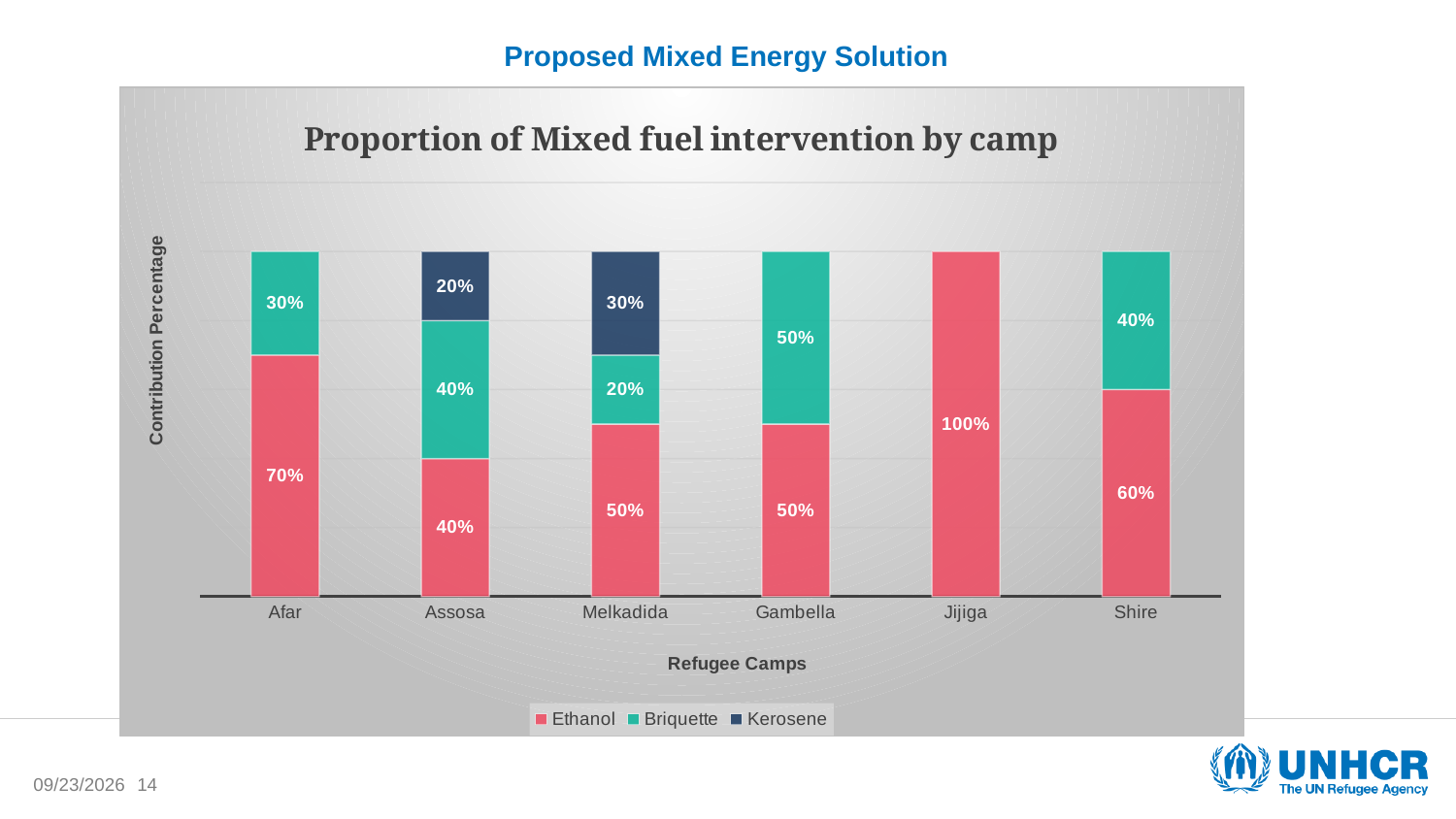
How many refugee camps are shown on the x axis? 6 What is the Kerosene value for Melkadida? 30% What is the difference between the Ethanol values for Afar and Shire? 10% How many series does the legend list? 3 What is the Briquette value for Gambella? 50% What is the Ethanol value for Afar? 70% What kind of chart is shown? Stacked bar chart Which camp has the highest Ethanol value? Jijiga Which is larger, the Briquette value for Assosa or the Briquette value for Shire? Neither; they are equal (both 40%) What is the title of the chart? Proportion of Mixed fuel intervention by camp What is the total of the stacked bar for Assosa? 100% Which camp has the lowest Ethanol value? Assosa